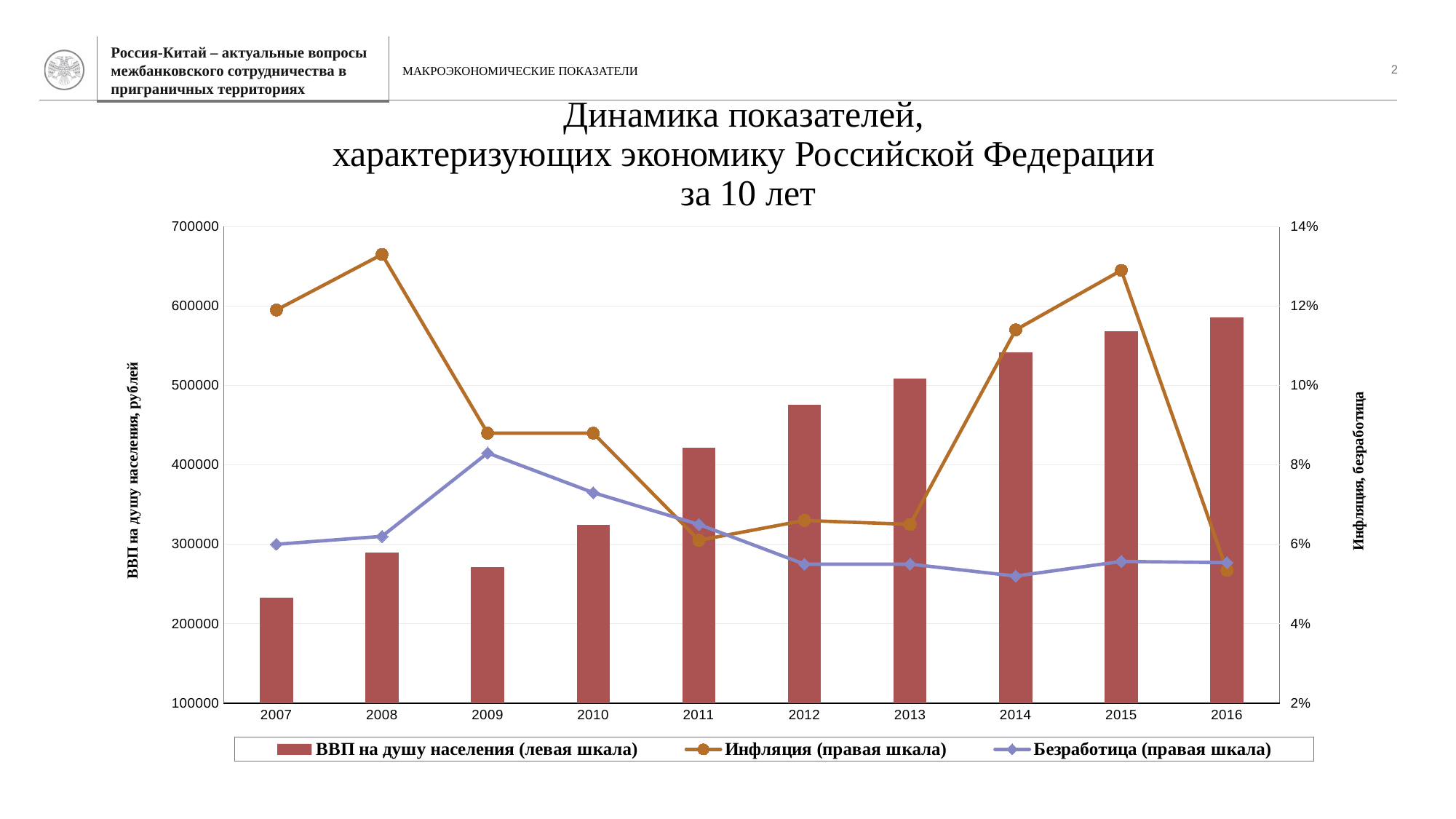
In which year does the Безработица line reach its highest point? 2009 Is the value for ВВП на душу населения in 2016 greater or less than 500000? greater What is the label of the right-hand vertical axis? Инфляция, безработица In which year is the bar for ВВП на душу населения the lowest? 2007 In which year does the Инфляция line reach its highest point? 2008 Is the value for Инфляция in 2008 greater or less than 12%? greater Which is larger, the Инфляция value in 2007 or in 2011? 2007 How many years are shown on the x axis of the chart? 10 Is the value for ВВП на душу населения in 2007 greater or less than 300000? less What kind of chart is shown on the slide? Combined bar and line chart How many series does the chart legend list? 3 In which year is the bar for ВВП на душу населения the highest? 2016